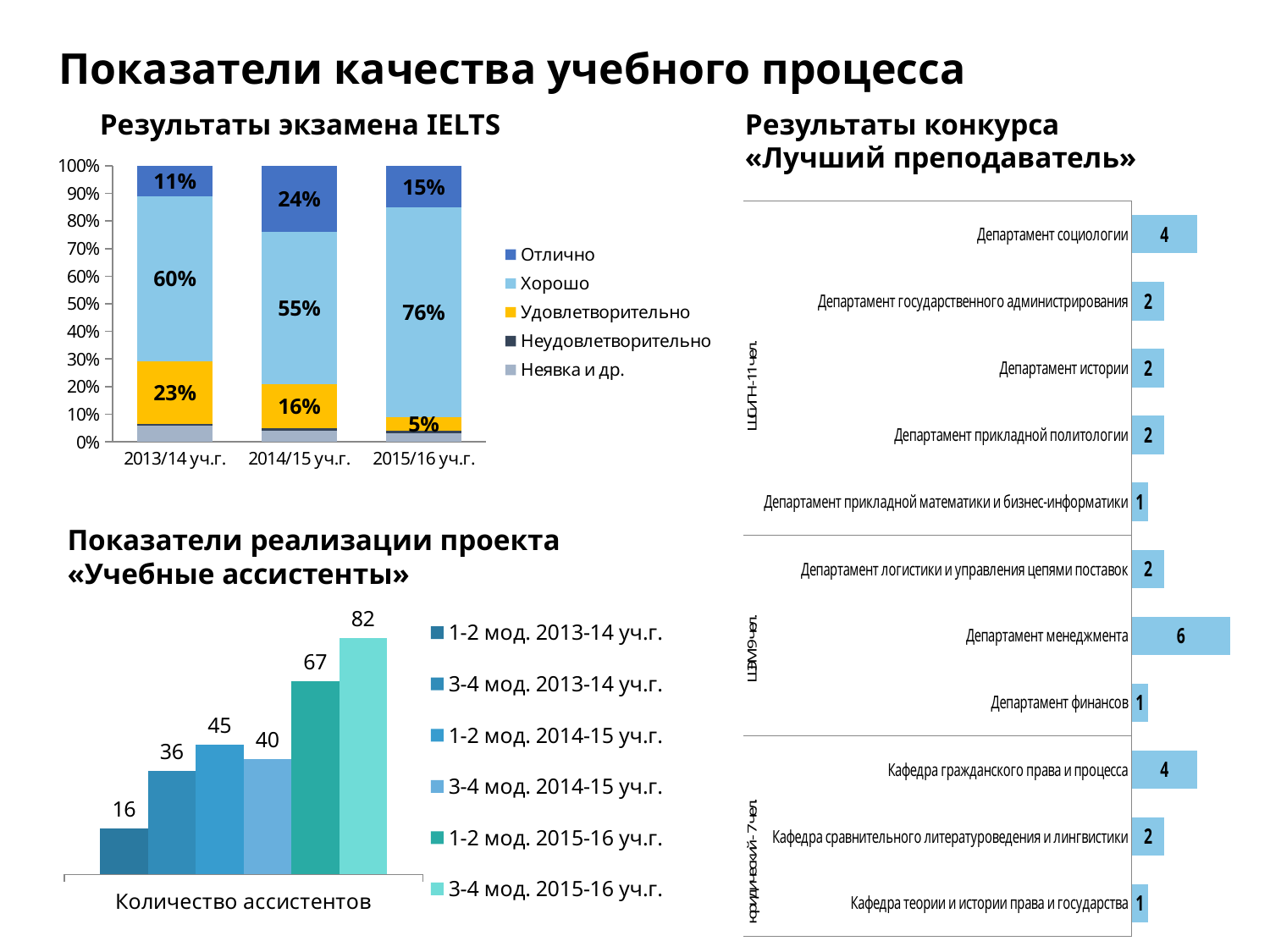
On the 'Результаты экзамена IELTS' chart, what kind of chart is it? Stacked bar chart On the 'Показатели реализации проекта «Учебные ассистенты»' chart, which series has the lowest value? 1-2 мод. 2013-14 уч.г. On the 'Результаты экзамена IELTS' chart, how many series does the legend list? 5 On the 'Результаты экзамена IELTS' chart, what is the value for 'Отлично' in 2014/15 уч.г.? 24% On the 'Результаты экзамена IELTS' chart, which academic year has the highest 'Отлично' share? 2014/15 уч.г. On the 'Результаты конкурса «Лучший преподаватель»' chart, what is the value for 'Департамент социологии'? 4 On the 'Показатели реализации проекта «Учебные ассистенты»' chart, what is the value for '3-4 мод. 2015-16 уч.г.'? 82 On the 'Результаты экзамена IELTS' chart, what is the difference between 'Удовлетворительно' in 2013/14 уч.г. and in 2015/16 уч.г.? 18% On the 'Результаты экзамена IELTS' chart, what is the value for 'Хорошо' in 2015/16 уч.г.? 76% On the 'Результаты конкурса «Лучший преподаватель»' chart, how many departments/chairs are listed? 11 On the 'Показатели реализации проекта «Учебные ассистенты»' chart, what is the difference between '1-2 мод. 2015-16 уч.г.' and '3-4 мод. 2014-15 уч.г.'? 27 On the 'Результаты конкурса «Лучший преподаватель»' chart, which department has the highest value? Департамент менеджмента